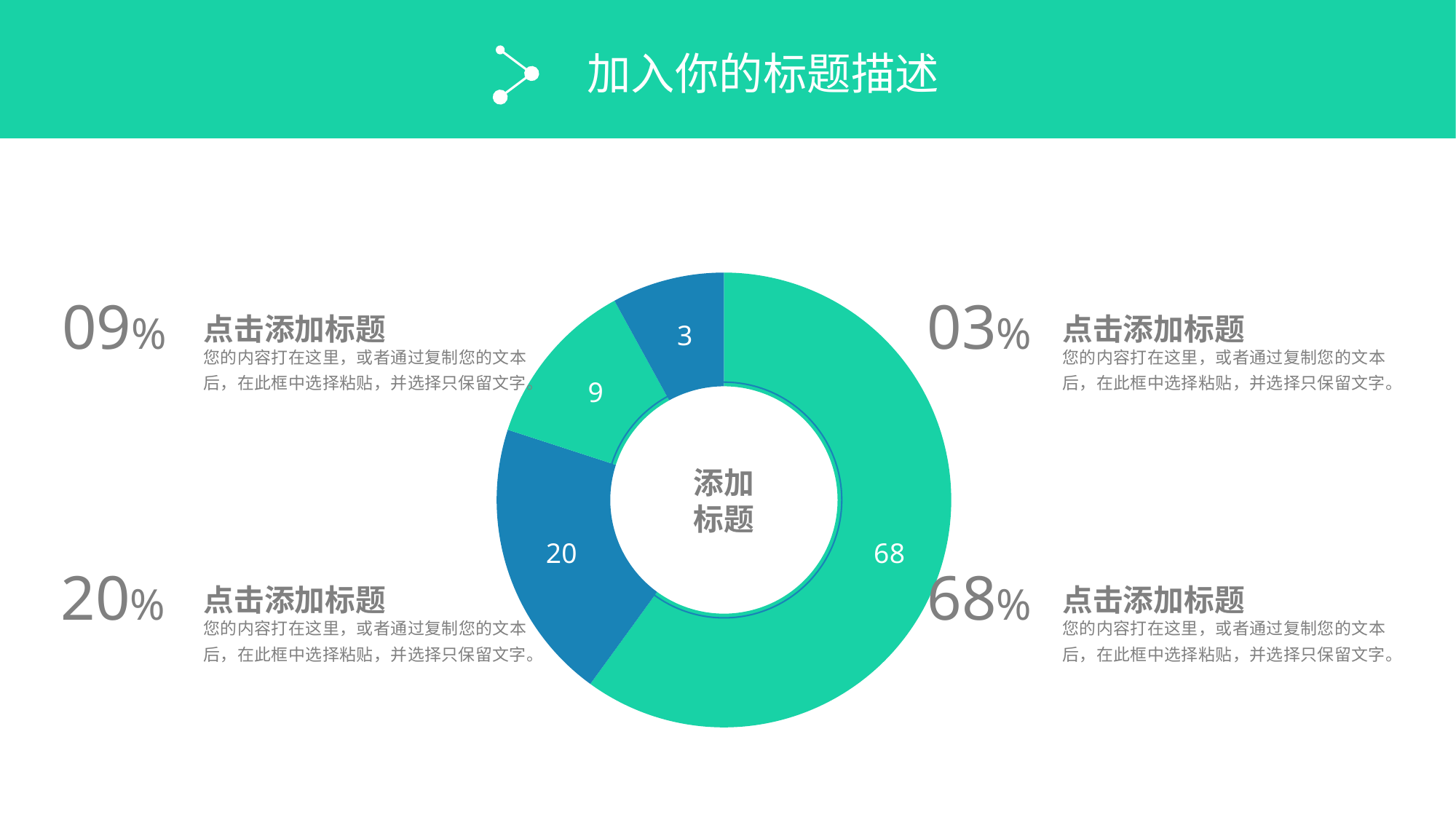
What colour is the largest slice (68) in the doughnut chart? green What share of the doughnut chart does the slice labelled 20 represent? 20% Which is larger in the doughnut chart, the slice labelled 20 or the slice labelled 9? 20 What is the value of the smallest slice in the doughnut chart? 3 How many slices does the doughnut chart have? 4 What is the total of all the slice values in the doughnut chart? 100 What text appears in the centre of the doughnut chart? 添加标题 What share of the doughnut chart does the largest slice (68) represent? 68% What is the difference between the largest slice (68) and the second-largest slice (20) in the doughnut chart? 48 What is the value of the largest slice in the doughnut chart? 68 What is the difference between the slice labelled 9 and the slice labelled 3 in the doughnut chart? 6 What kind of chart is shown on the slide? doughnut chart